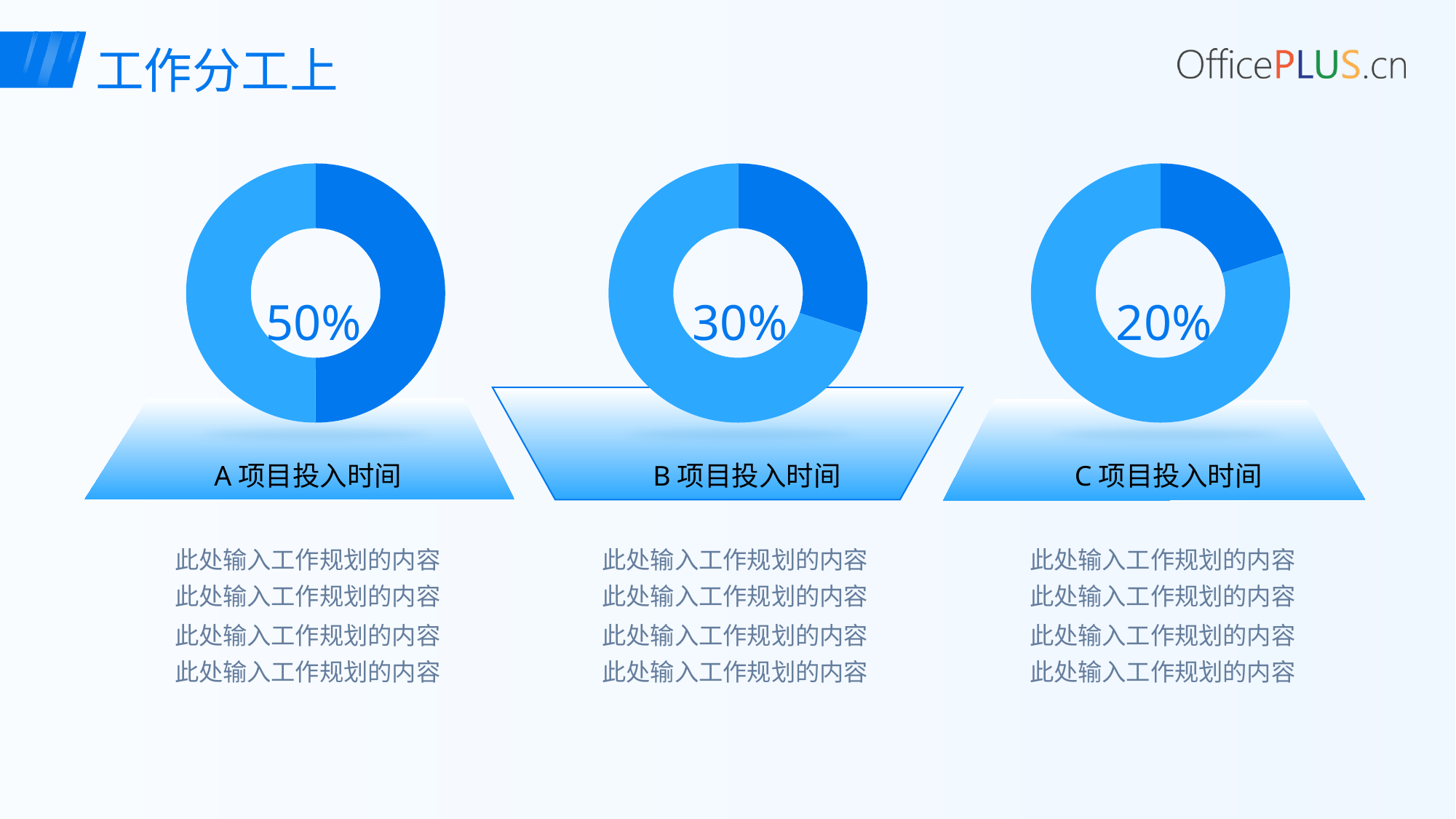
Which is larger, the percentage for B 项目投入时间 or the percentage for C 项目投入时间? B 项目投入时间 What percentage is shown in the centre of the donut chart labelled C 项目投入时间? 20% What is the title of the slide containing the three donut charts? 工作分工上 What percentage is shown in the centre of the donut chart labelled A 项目投入时间? 50% What kind of chart is used to show each project's time investment on this slide? Donut (pie) chart What is the difference between the percentage for B 项目投入时间 and the percentage for C 项目投入时间? 10% What is the difference between the percentage for A 项目投入时间 and the percentage for C 项目投入时间? 30% What percentage is shown in the centre of the donut chart labelled B 项目投入时间? 30% In the donut chart for A 项目投入时间, what share of the ring does the darker blue slice represent? 50% Which of the three projects (A, B or C) has the highest percentage of time invested? A 项目投入时间 Which of the three projects (A, B or C) has the lowest percentage of time invested? C 项目投入时间 How many donut charts are shown on the slide? 3